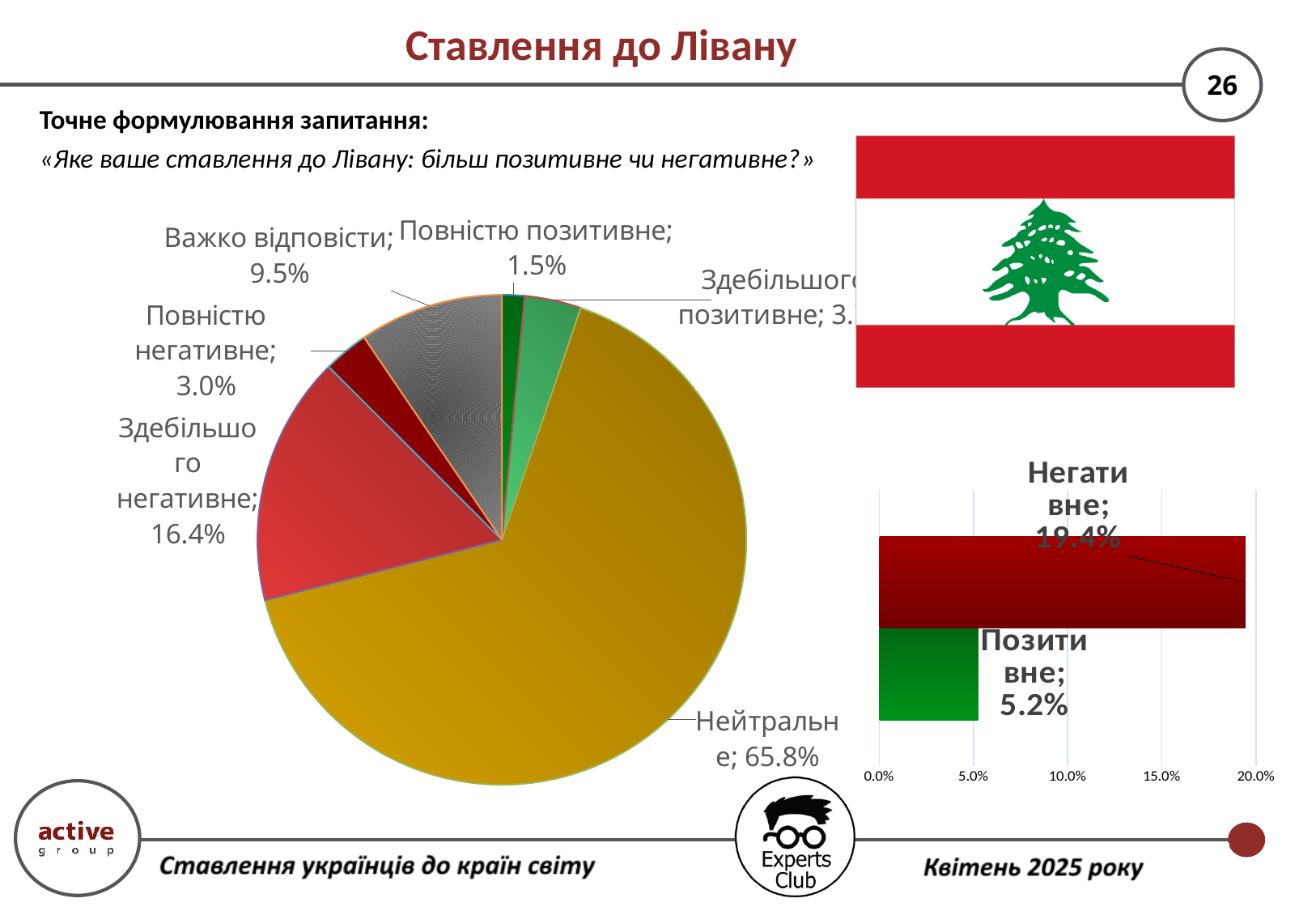
In the pie chart, which category has the largest share? Нейтральне In the pie chart, which category has the smallest share? Повністю позитивне In the bar chart on the right, how many percentage points larger is "Негативне" than "Позитивне"? 14.2 In the pie chart, what is the value for "Повністю негативне"? 3.0% In the pie chart, what share of respondents answered "Нейтральне"? 65.8% In the pie chart, how many percentage points larger is "Здебільшого негативне" than "Повністю негативне"? 13.4 In the pie chart, how many slices are there? 6 In the bar chart on the right, what is the value for "Негативне"? 19.4% In the pie chart, what is the value for "Здебільшого негативне"? 16.4% In the bar chart on the right, what is the value for "Позитивне"? 5.2% In the pie chart, what is the value for "Важко відповісти"? 9.5% What type of chart is shown on the right side of the slide below the flag? Bar chart